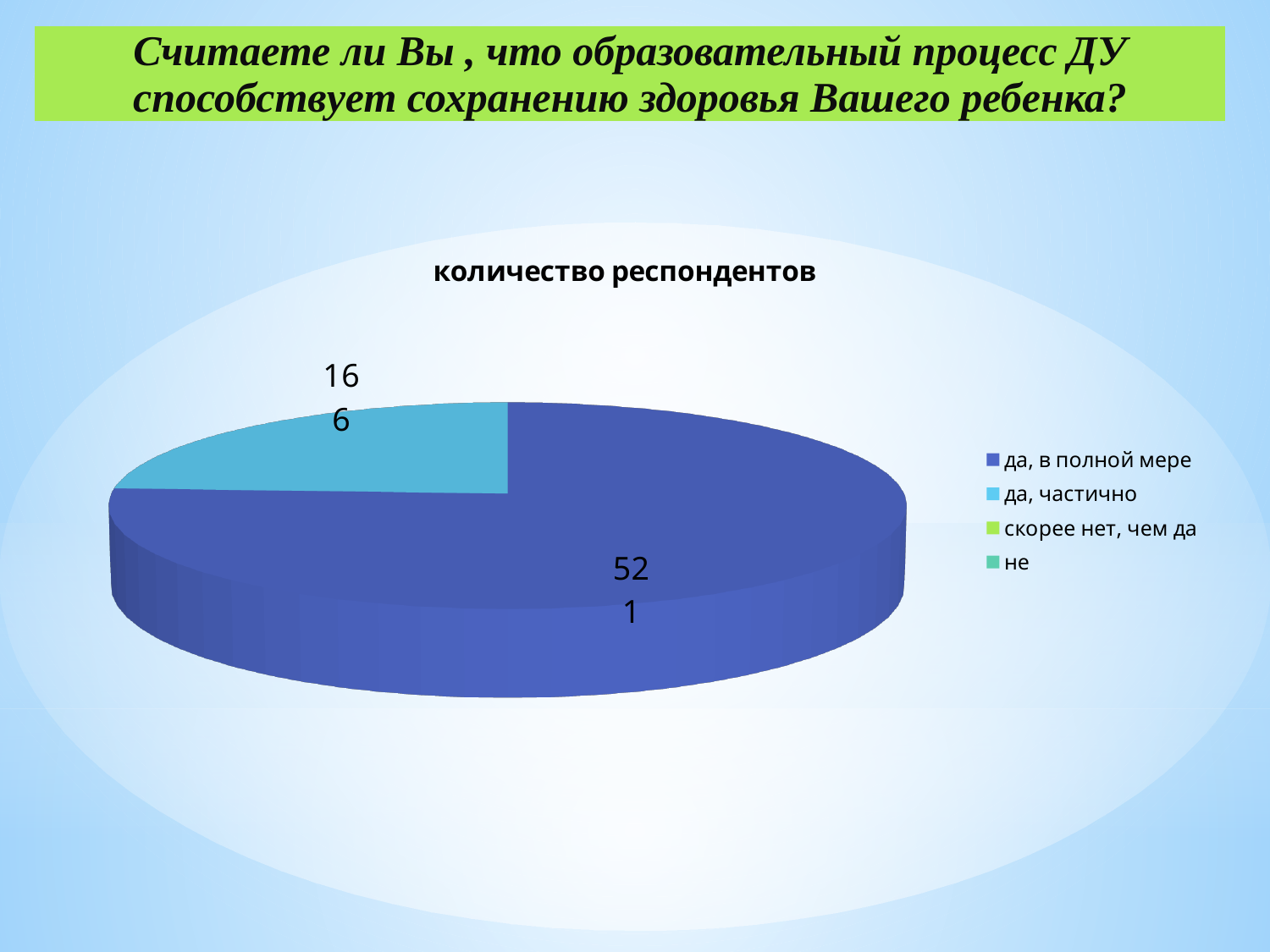
Which is larger, the slice for "да, в полной мере" or the slice for "да, частично"? да, в полной мере How many entries does the chart legend list? 4 Does the slice for "да, в полной мере" take up more or less than half of the pie? more Which legend entry is shown in dark blue? да, в полной мере Which category has the largest slice of the pie? да, в полной мере What kind of chart is shown on the slide? pie chart What is the title of the chart? количество респондентов